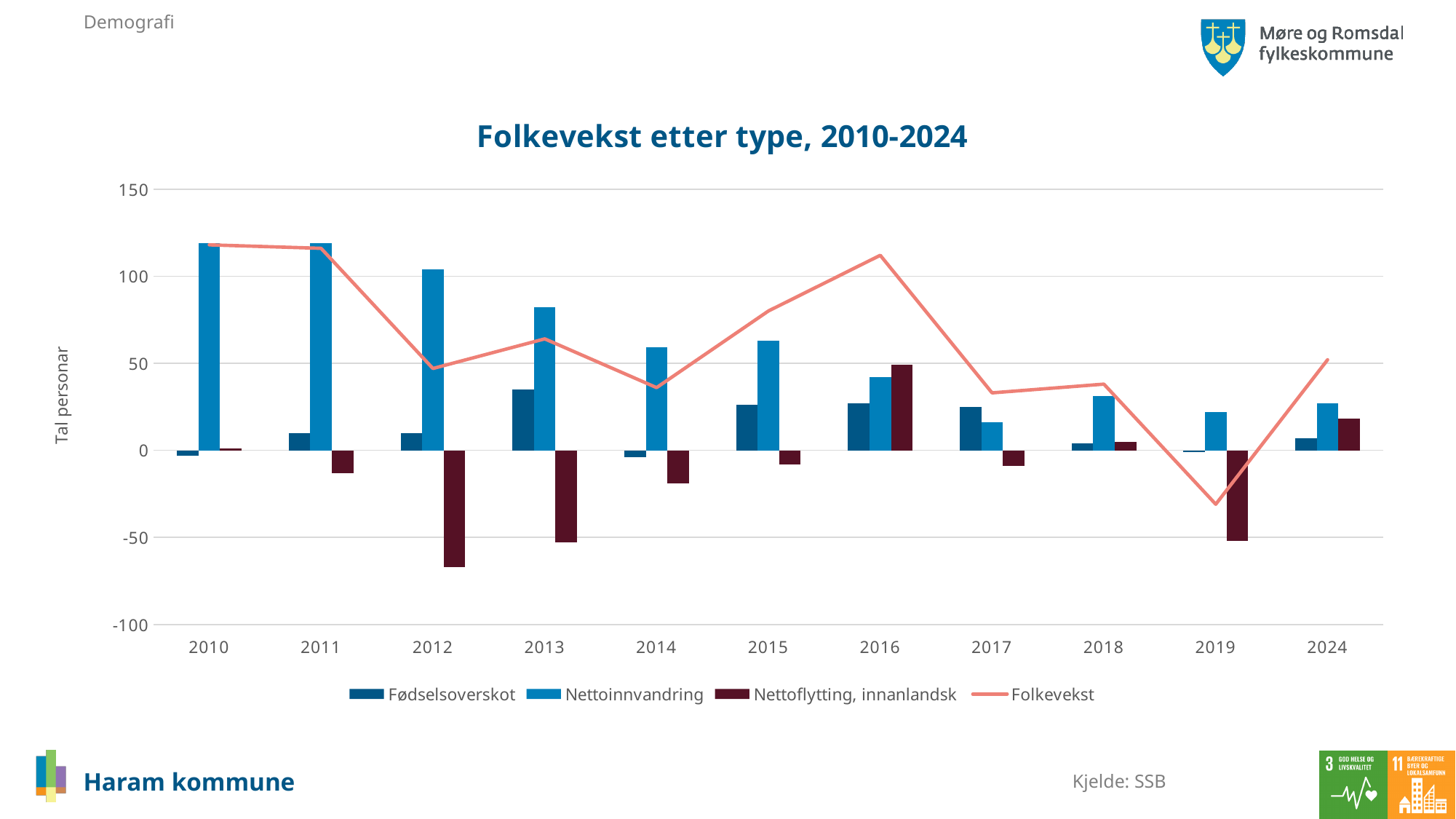
Which year has the highest value for Nettoflytting, innanlandsk? 2016 In which year is the Folkevekst line at its lowest? 2019 Which year has the highest value for Fødselsoverskot? 2013 How many series does the legend list? 4 Which is larger, Nettoinnvandring in 2015 or in 2016? 2015 Is the value for Nettoinnvandring in 2013 greater or less than 50? greater Which year has the lowest value for Nettoflytting, innanlandsk? 2012 Is the value for Nettoflytting, innanlandsk in 2012 greater or less than -50? less What kind of chart is shown on the slide? Bar chart with a line Is the Folkevekst value in 2016 greater or less than 100? greater Does the Folkevekst line rise or fall from 2016 to 2019? fall How many years are shown on the x axis? 11